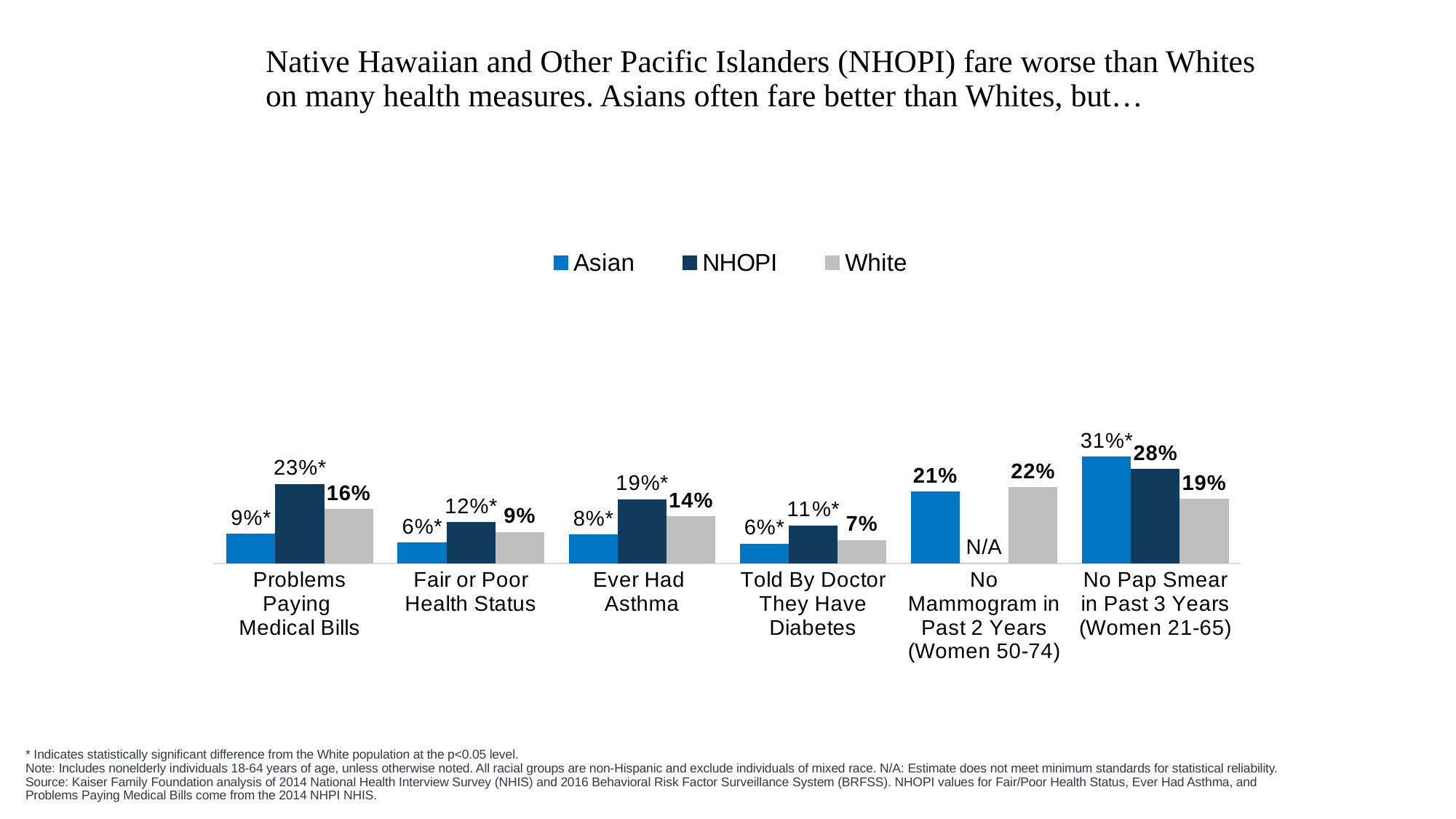
What is the NHOPI value for Problems Paying Medical Bills? 23% Which series is shown in light grey in the legend? White Which category has the highest Asian value? No Pap Smear in Past 3 Years (Women 21-65) How many series does the legend list? 3 What is the White value for Ever Had Asthma? 14% What kind of chart is shown on the slide? Bar chart What is the Asian value for No Pap Smear in Past 3 Years (Women 21-65)? 31% What is the difference between the NHOPI and White values for Ever Had Asthma? 5% Which is larger for Fair or Poor Health Status, the NHOPI value or the White value? NHOPI Which category has the lowest White value? Told By Doctor They Have Diabetes How many categories are shown along the x axis? 6 What is shown for NHOPI in the No Mammogram in Past 2 Years (Women 50-74) category? N/A